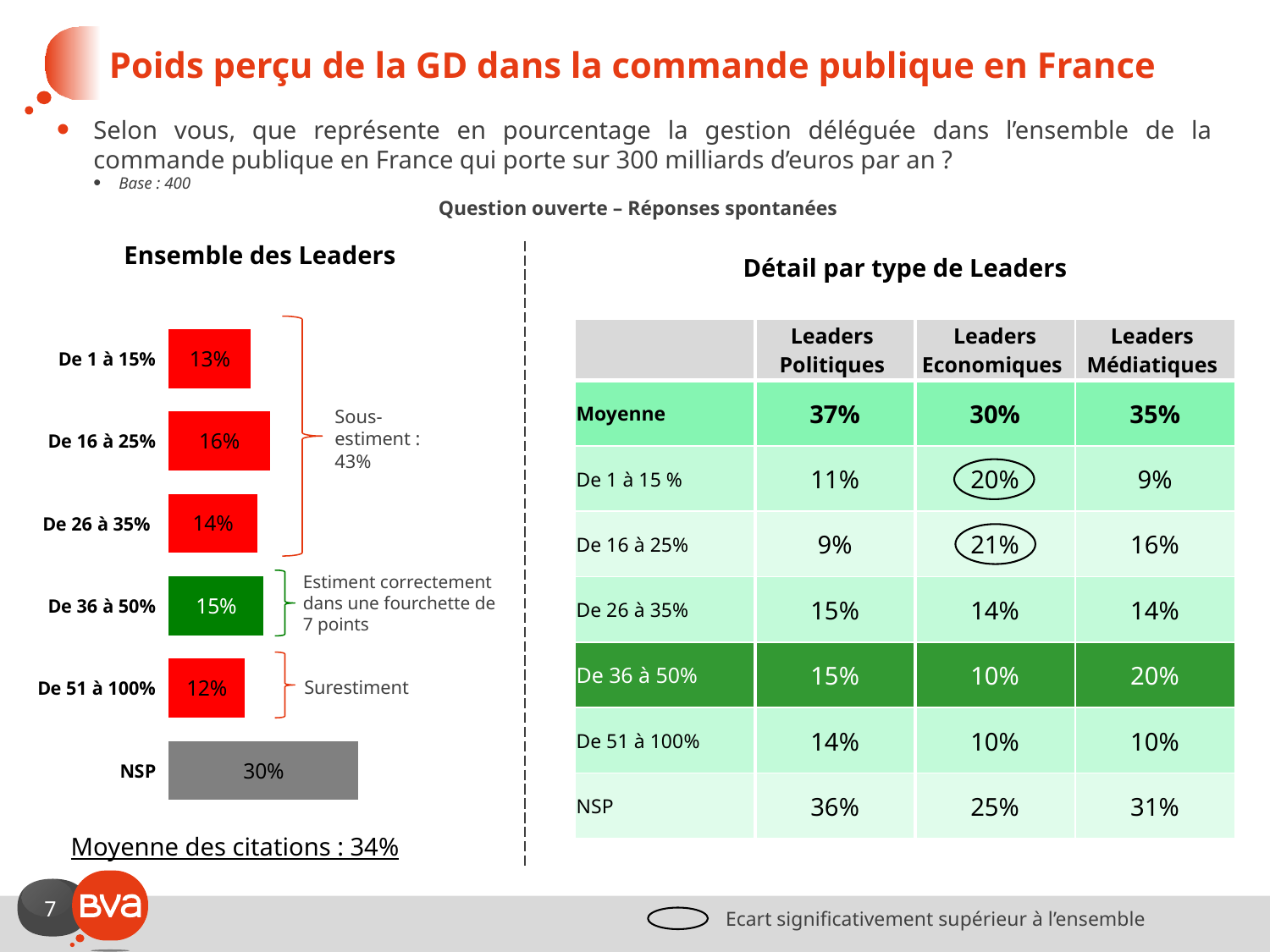
In the 'Ensemble des Leaders' chart, which category has the highest value? NSP In the 'Ensemble des Leaders' chart, what is the difference between the values for 'De 36 à 50%' and 'De 1 à 15%'? 2 percentage points In the 'Ensemble des Leaders' chart, what is the 'Moyenne des citations' shown below the chart? 34% In the 'Ensemble des Leaders' chart, what is the difference between the values for 'NSP' and 'De 16 à 25%'? 14 percentage points In the 'Ensemble des Leaders' chart, which category has the lowest value? De 51 à 100% In the 'Ensemble des Leaders' chart, what is the value for 'De 16 à 25%'? 16% In the 'Ensemble des Leaders' chart, what is the value for 'De 51 à 100%'? 12% In the 'Ensemble des Leaders' chart, what colour is the bar for 'De 36 à 50%'? Green How many categories are shown in the 'Ensemble des Leaders' chart? 6 In the 'Ensemble des Leaders' chart, which is larger: the value for 'De 16 à 25%' or the value for 'De 26 à 35%'? De 16 à 25% What kind of chart is the 'Ensemble des Leaders' chart? Bar chart In the 'Ensemble des Leaders' chart, what is the value for 'NSP'? 30%